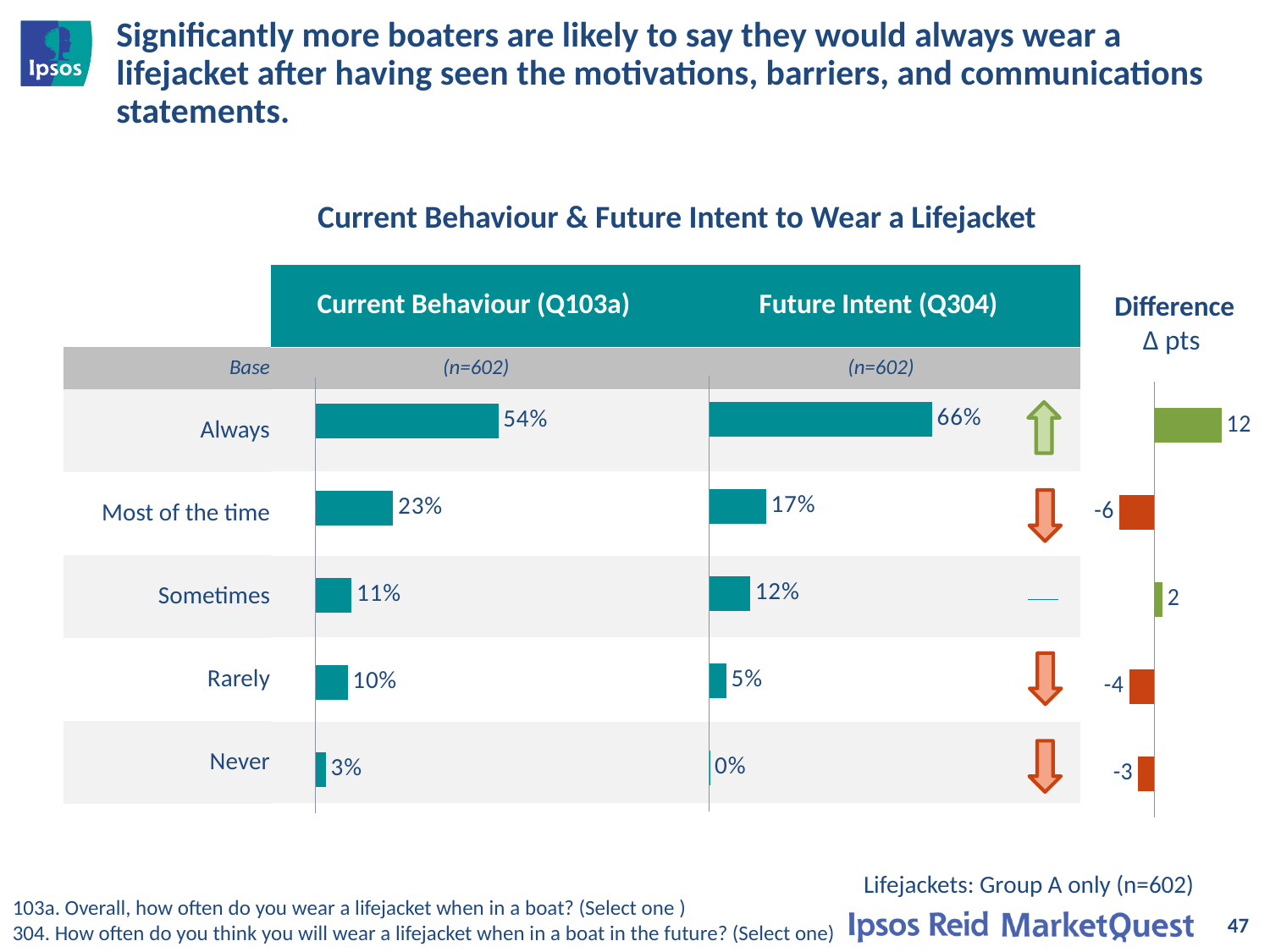
What is the difference between the Future Intent (Q304) and Current Behaviour (Q103a) values for Always? 12 Which is larger: the Current Behaviour (Q103a) value for Most of the time or the Future Intent (Q304) value for Most of the time? Current Behaviour (Q103a) In the Current Behaviour (Q103a) chart, which category has the highest value? Always What type of chart is used for the Current Behaviour (Q103a) data? Bar chart In the Future Intent (Q304) chart, what percentage of boaters say they will always wear a lifejacket? 66% How many categories are shown in the Current Behaviour (Q103a) chart? 5 In the Current Behaviour (Q103a) chart, what percentage of boaters say they always wear a lifejacket? 54% What is the title of the chart on the slide? Current Behaviour & Future Intent to Wear a Lifejacket In the Current Behaviour (Q103a) chart, what is the value for Never? 3% In the Future Intent (Q304) chart, which category has the lowest value? Never In the Difference chart, what is the difference in points for Most of the time? -6 In the Future Intent (Q304) chart, what is the value for Rarely? 5%